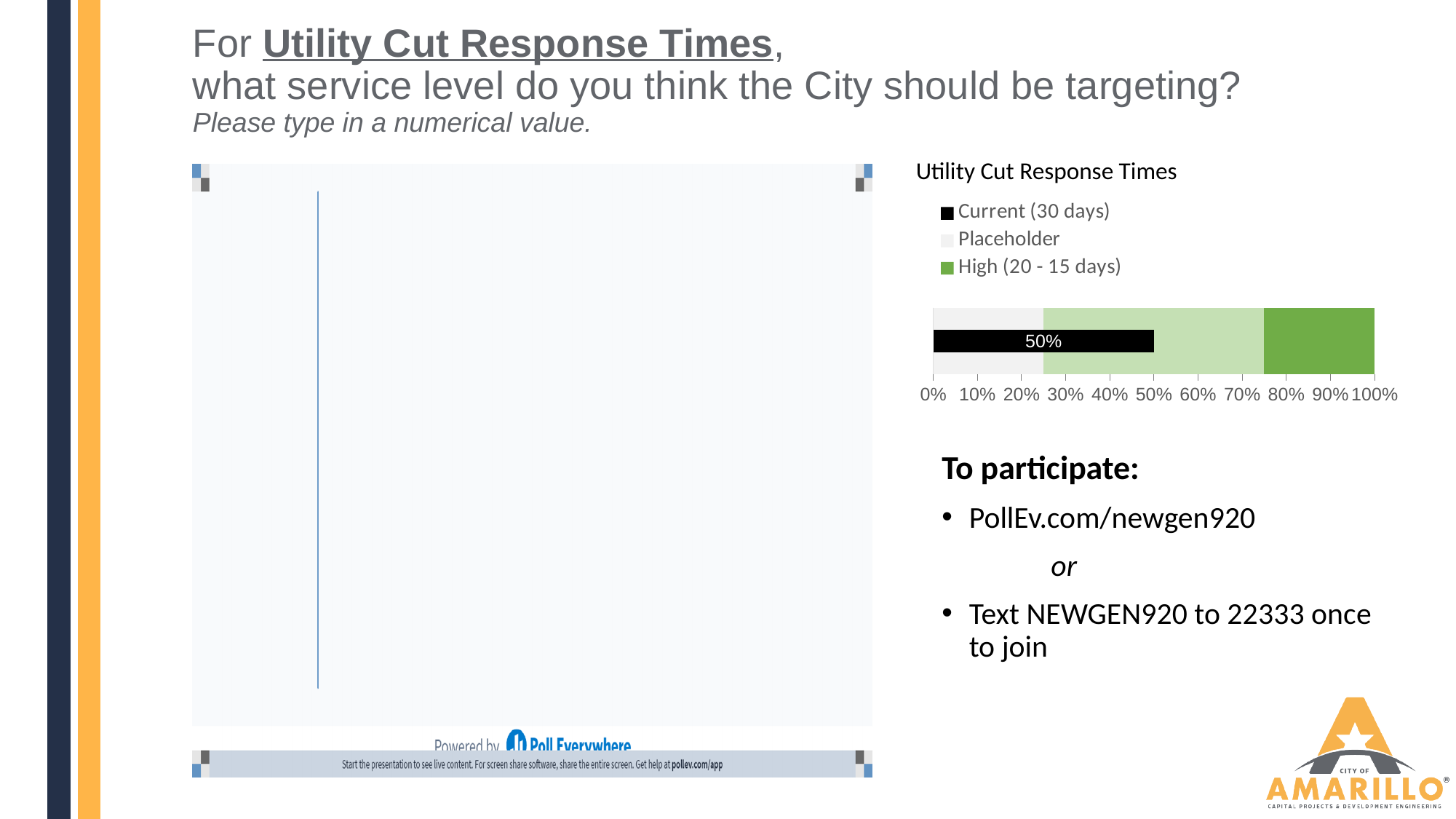
What is the highest value shown on the x axis of the Utility Cut Response Times chart? 100% In the Utility Cut Response Times chart, is the value for Current (30 days) greater or less than 60%? less What kind of chart is the Utility Cut Response Times chart? bar chart In the Utility Cut Response Times chart, what colour represents the Current (30 days) series? black In the Utility Cut Response Times chart, which legend entry is shown in green? High (20 - 15 days) In the Utility Cut Response Times chart, is the value for Current (30 days) greater or less than 40%? greater How many series does the legend of the Utility Cut Response Times chart list? 3 In the Utility Cut Response Times chart, what value is printed on the Current (30 days) bar? 50%